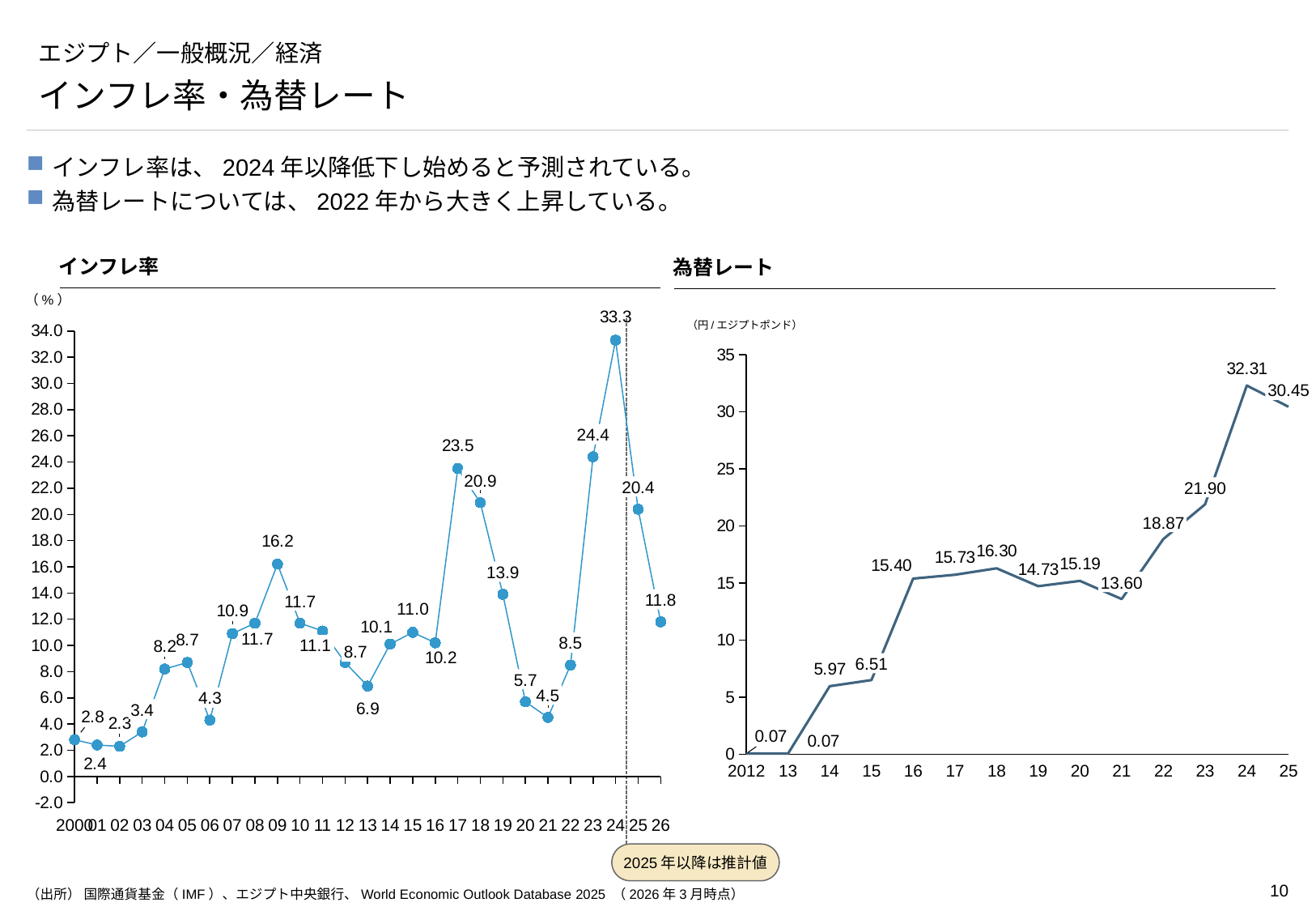
In the インフレ率 chart, what is the inflation rate for 2017? 23.5 In the 為替レート chart, how many years are plotted on the x axis? 14 In the 為替レート chart, what is the value for 2021? 13.60 In the インフレ率 chart, which year has the highest inflation rate? 2024 In the 為替レート chart, what is the value for 2024? 32.31 In the 為替レート chart, which year has the highest value? 2024 What type of chart is the インフレ率 chart? Line chart In the インフレ率 chart, which year has the lowest inflation rate? 2002 In the インフレ率 chart, what is the difference between the 2024 value and the 2025 value? 12.9 In the インフレ率 chart, what is the inflation rate for 2024? 33.3 In the インフレ率 chart, which is larger, the value for 2009 or the value for 2019? 2009 In the 為替レート chart, what is the difference between the 2023 value and the 2022 value? 3.03